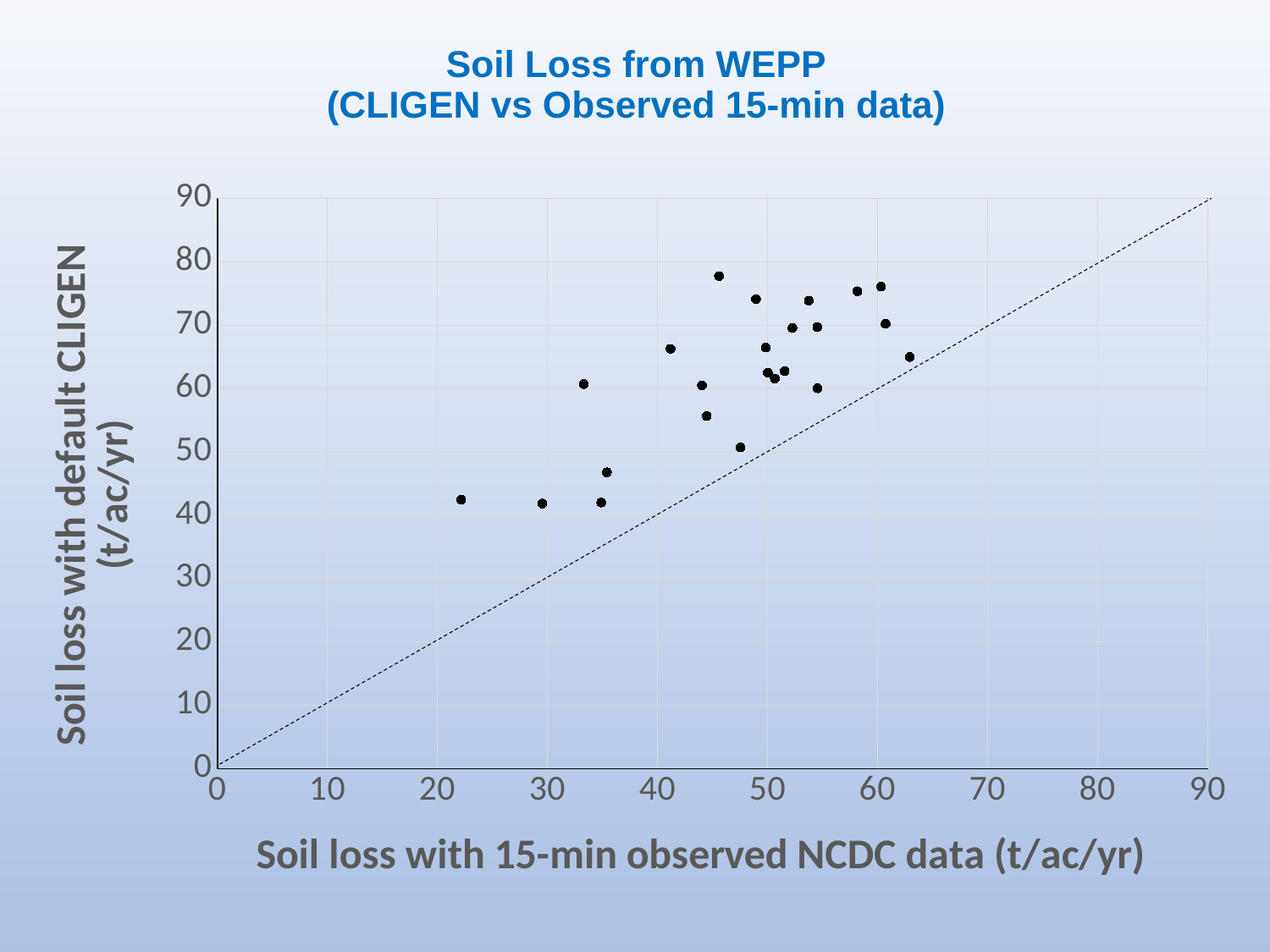
What is the title of the chart? Soil Loss from WEPP (CLIGEN vs Observed 15-min data) Is the smallest observed NCDC soil loss value plotted greater or less than 30 t/ac/yr? Less Do the plotted points lie above or below the dashed 1:1 line? Above Is the largest observed NCDC soil loss value plotted greater or less than 70 t/ac/yr? Less What is the label of the x axis? Soil loss with 15-min observed NCDC data (t/ac/yr) What kind of chart is shown on the slide? Scatter plot As the observed NCDC soil loss increases along the x axis, do the CLIGEN soil loss values generally rise or fall? Rise How many data points are plotted on the chart? 23 Is the highest CLIGEN soil loss value plotted greater or less than 70 t/ac/yr? Greater